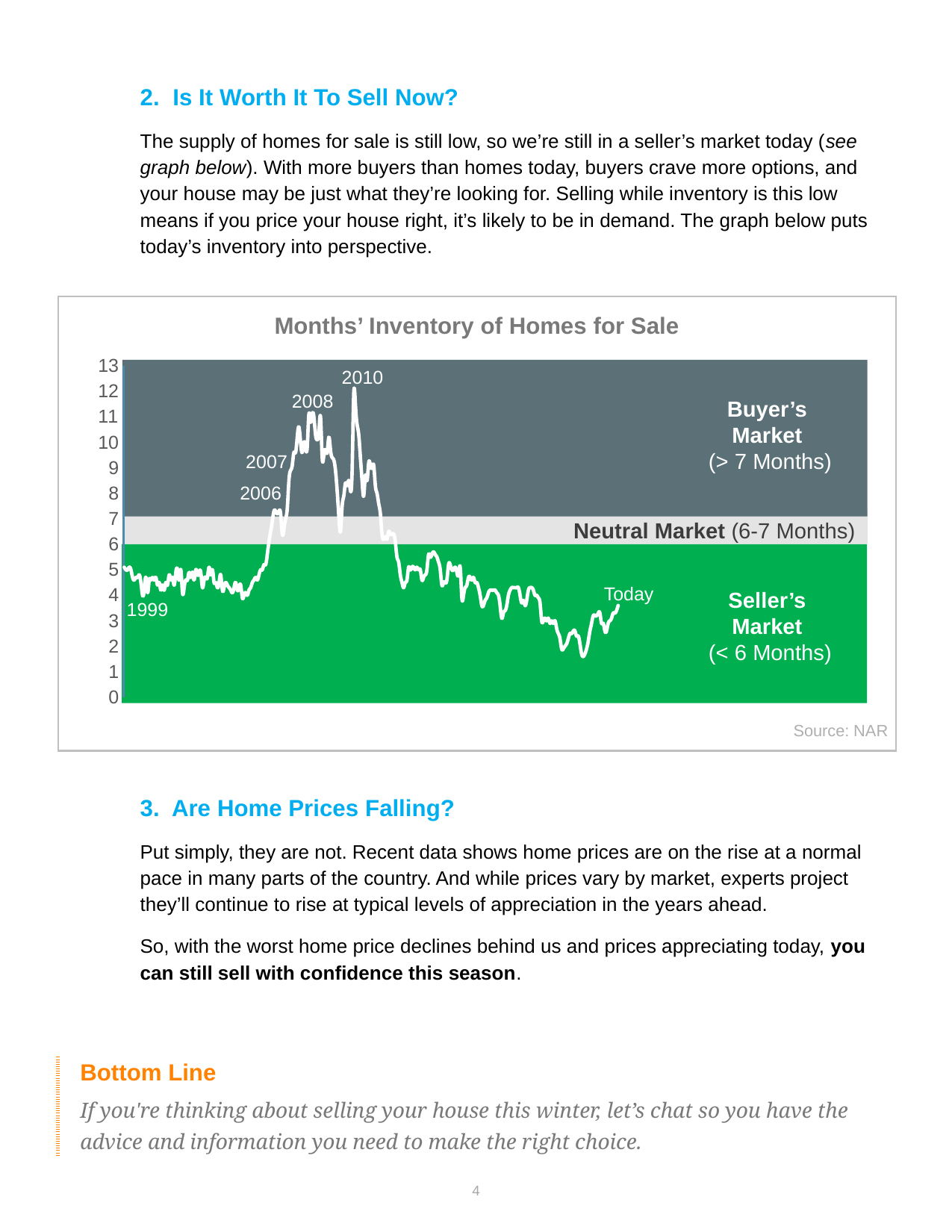
What kind of chart is shown on the slide? line chart Is the value for 2006 greater or less than 5? greater What is the highest value shown on the chart's vertical axis? 13 What is the title of the chart? Months' Inventory of Homes for Sale Is the value for 1999 greater or less than 6? less Which market zone does the Today value fall in? Seller's Market Does the months' inventory rise or fall from 2010 to Today? fall Is the peak value for 2010 greater or less than 11? greater Which labeled year on the chart has the highest peak in months' inventory? 2010 Which is larger, the peak value for 2010 or the value labeled Today? 2010